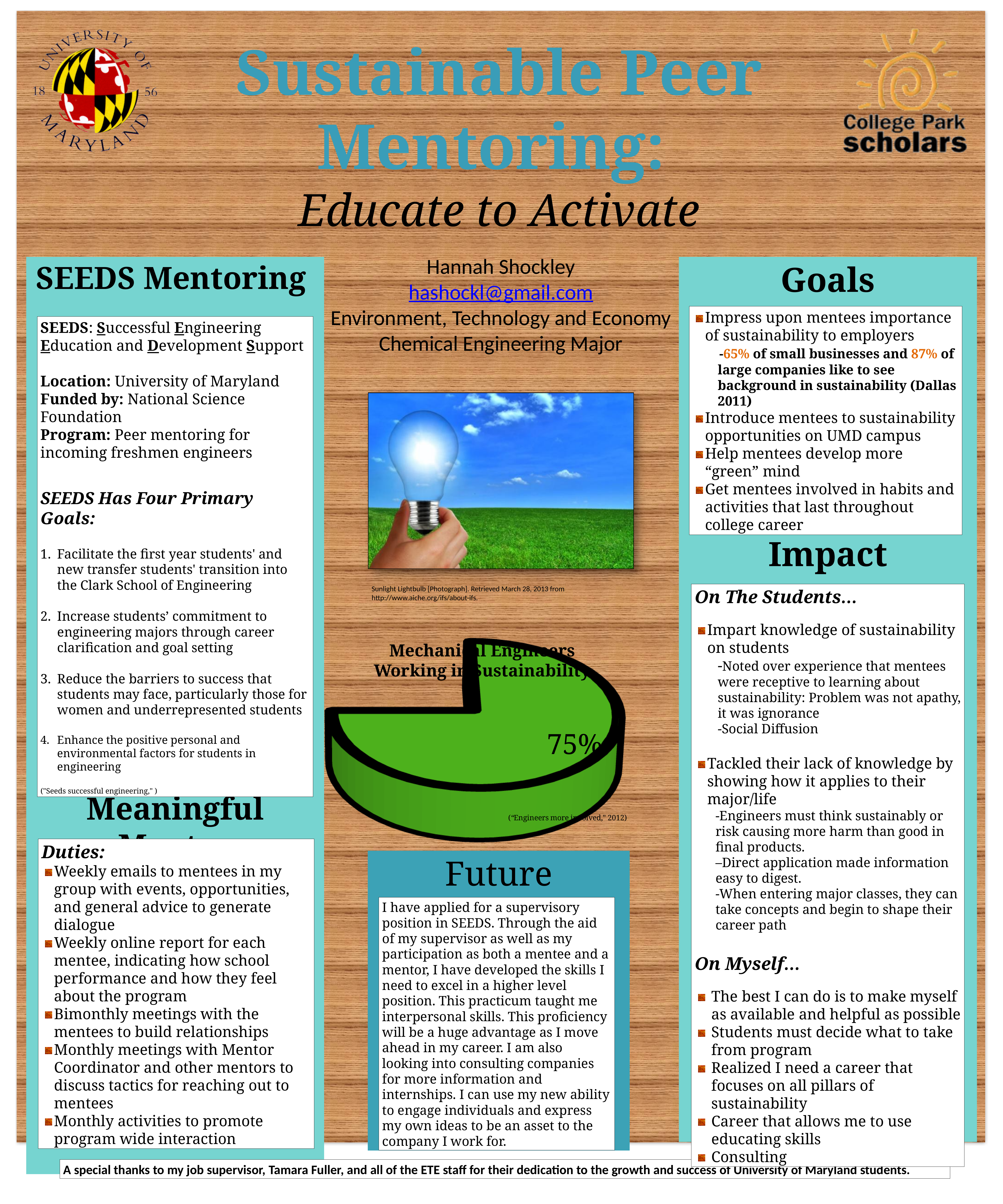
Is the value shown on the pie chart greater or less than 50%? greater How many data labels are printed on the pie chart? 1 What kind of chart is shown in the middle of the slide? pie chart What is the title of the pie chart? Mechanical Engineers Working in Sustainability What share of the pie does the green slice represent? 75% What percentage is printed on the pie chart's slice? 75% What colour is the labelled slice of the pie chart? green